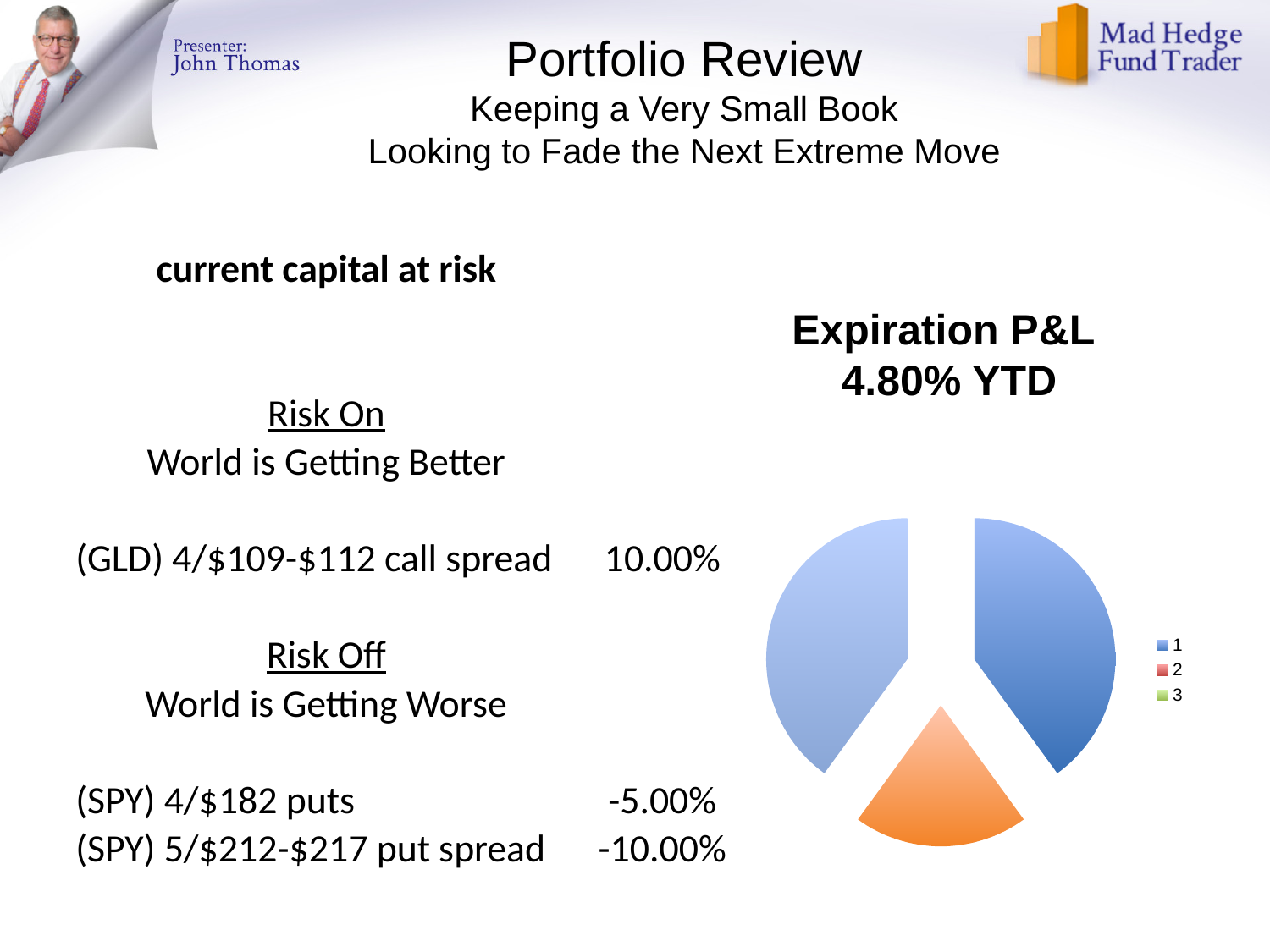
What heading appears above the pie chart? Expiration P&L 4.80% YTD Is the orange slice of the pie chart larger or smaller than the dark blue slice? smaller How many slices does the pie chart have? 3 What kind of chart is shown on the slide? pie chart Which slice of the pie chart is the smallest? the orange slice What are the entries listed in the pie chart's legend? 1, 2, 3 How many entries does the pie chart's legend list? 3